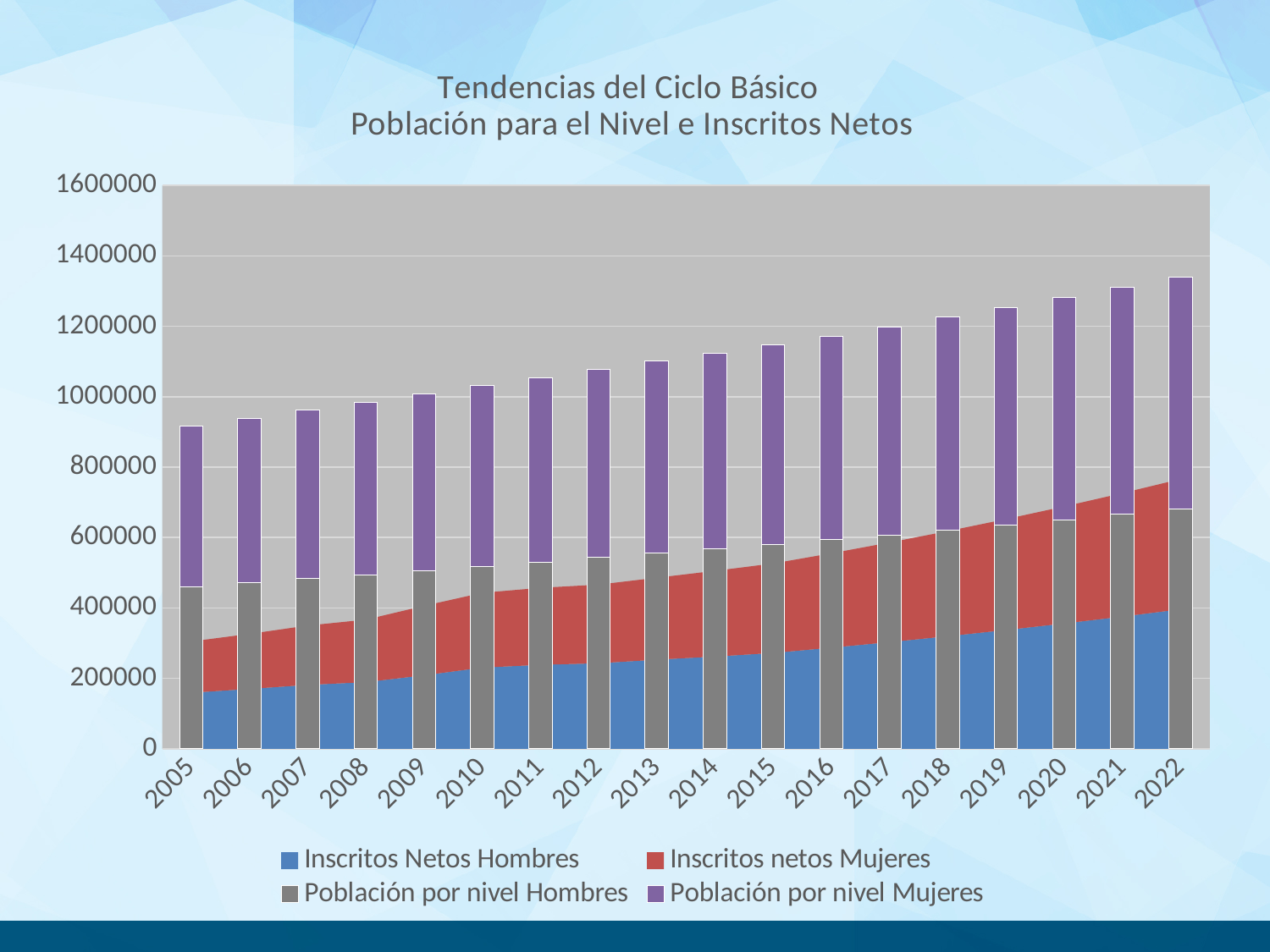
Is the total height of the stacked bar for 2022 greater or less than 1200000? greater Do the stacked Población por nivel bars rise or fall from 2005 to 2022? rise Is the value for Población por nivel Hombres in 2022 greater or less than 600000? greater How many years are shown along the x axis? 18 Which is larger in 2022: the stacked bar for Población por nivel or the stacked area for Inscritos netos? Población por nivel Which year has the tallest stacked bar for Población por nivel? 2022 What is the title of the chart? Tendencias del Ciclo Básico Población para el Nivel e Inscritos Netos Which colour represents Población por nivel Mujeres in the legend? purple How many series does the legend list? 4 Which year has the shortest stacked bar for Población por nivel? 2005 Is the value for Inscritos Netos Hombres in 2005 greater or less than 200000? less